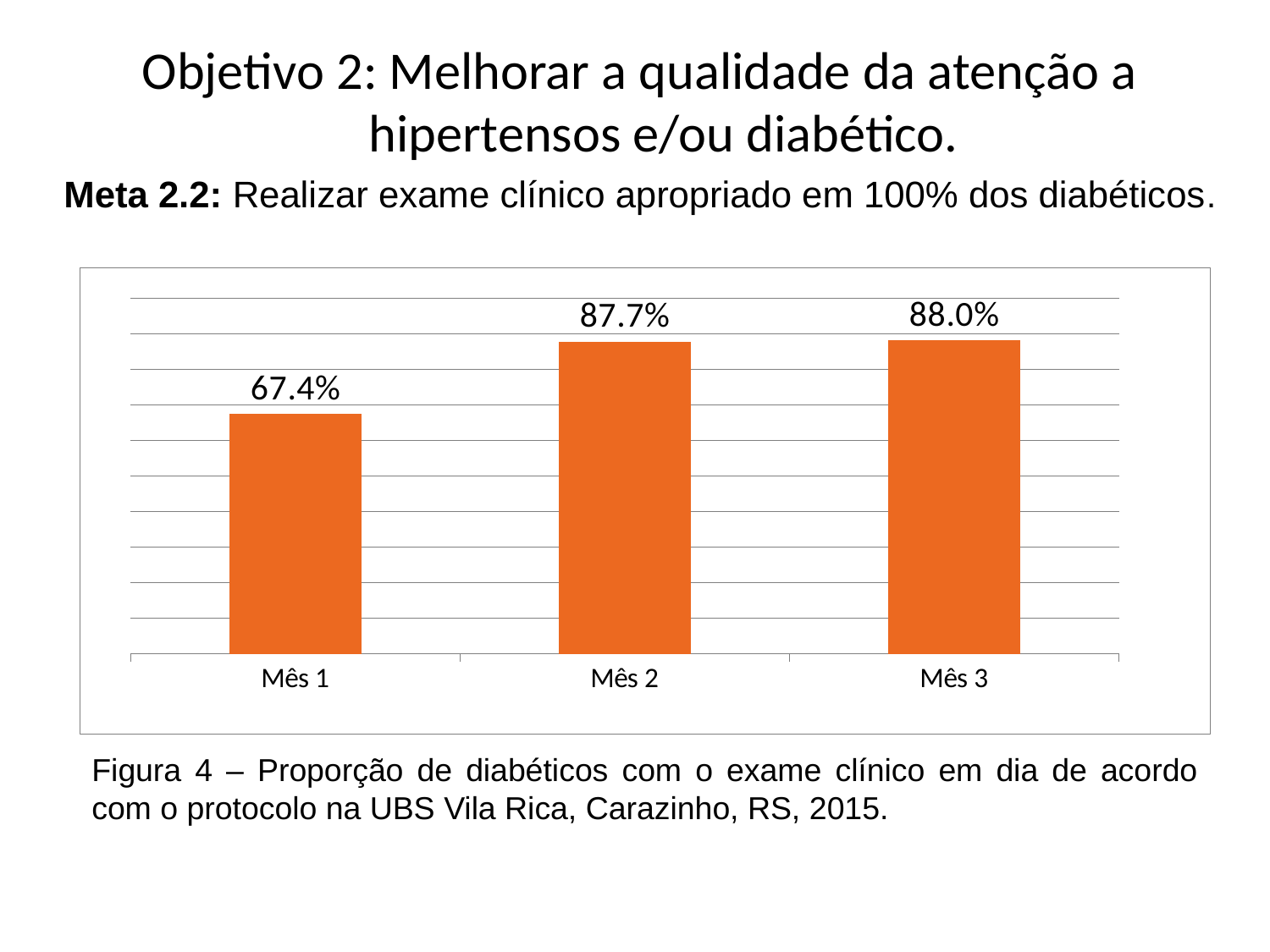
What is the value for Mês 3? 88.0% What is the value for Mês 1? 67.4% What is the figure number given in the caption below the chart? Figura 4 What is the value for Mês 2? 87.7% What is the difference between the values for Mês 3 and Mês 2? 0.3% What kind of chart is shown on the slide? Bar chart Which month has the lowest value? Mês 1 Do the values rise or fall from Mês 1 to Mês 3? Rise How many months are shown on the chart? 3 Which is larger, the value for Mês 1 or the value for Mês 2? Mês 2 What is the difference between the values for Mês 2 and Mês 1? 20.3% What colour are the bars in the chart? Orange